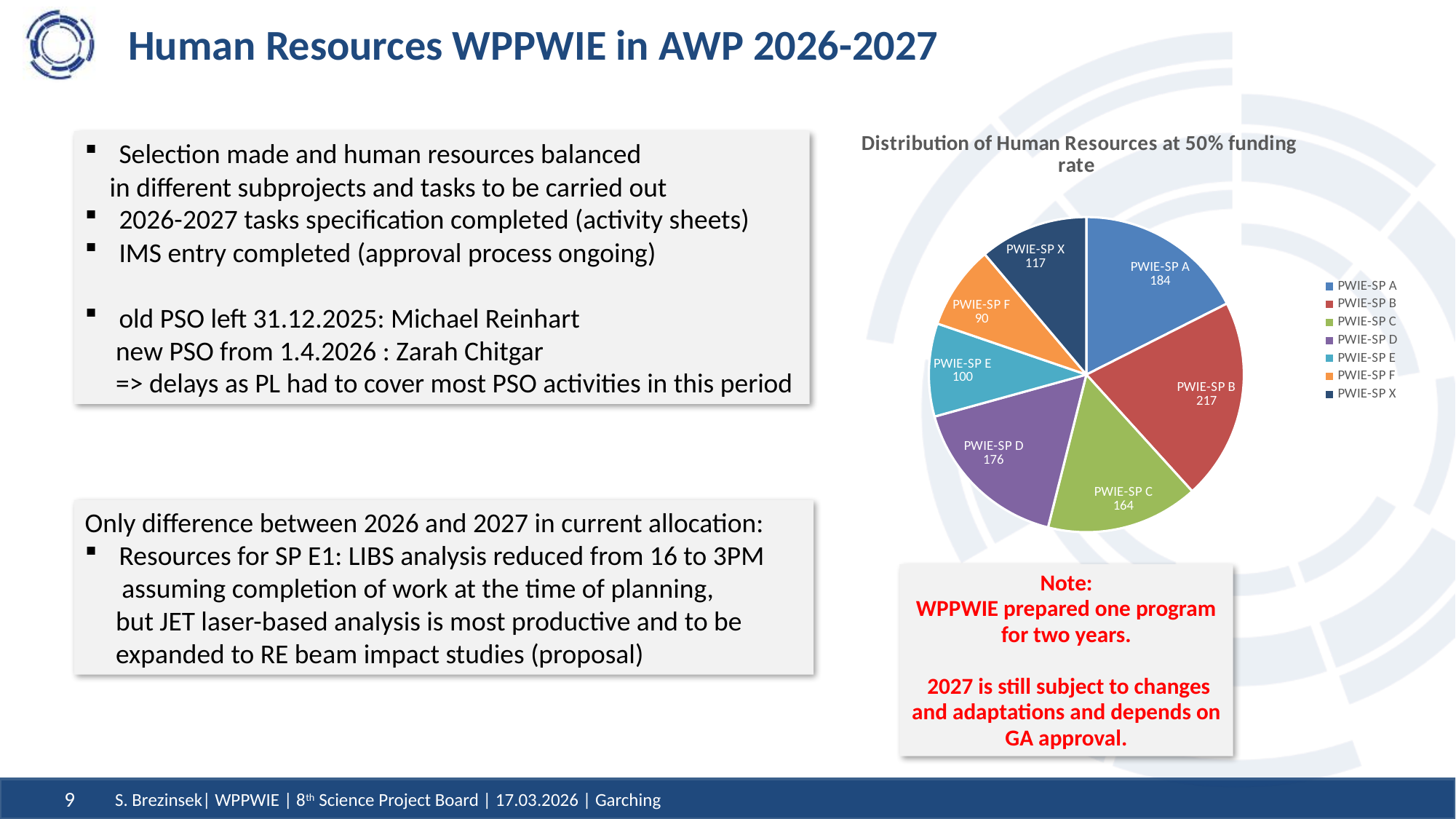
Which subproject has the largest slice of the pie? PWIE-SP B What is the difference between the values for PWIE-SP B and PWIE-SP A? 33 What is the value for PWIE-SP X? 117 Which is larger, the value for PWIE-SP D or PWIE-SP C? PWIE-SP D What is the total of all slices in the pie chart? 1048 What is the value for PWIE-SP E? 100 Which subproject has the smallest slice of the pie? PWIE-SP F What is the title of the chart? Distribution of Human Resources at 50% funding rate What type of chart is shown on the slide? pie chart How many slices does the pie chart have? 7 How many entries does the legend list? 7 What is the value for PWIE-SP B? 217